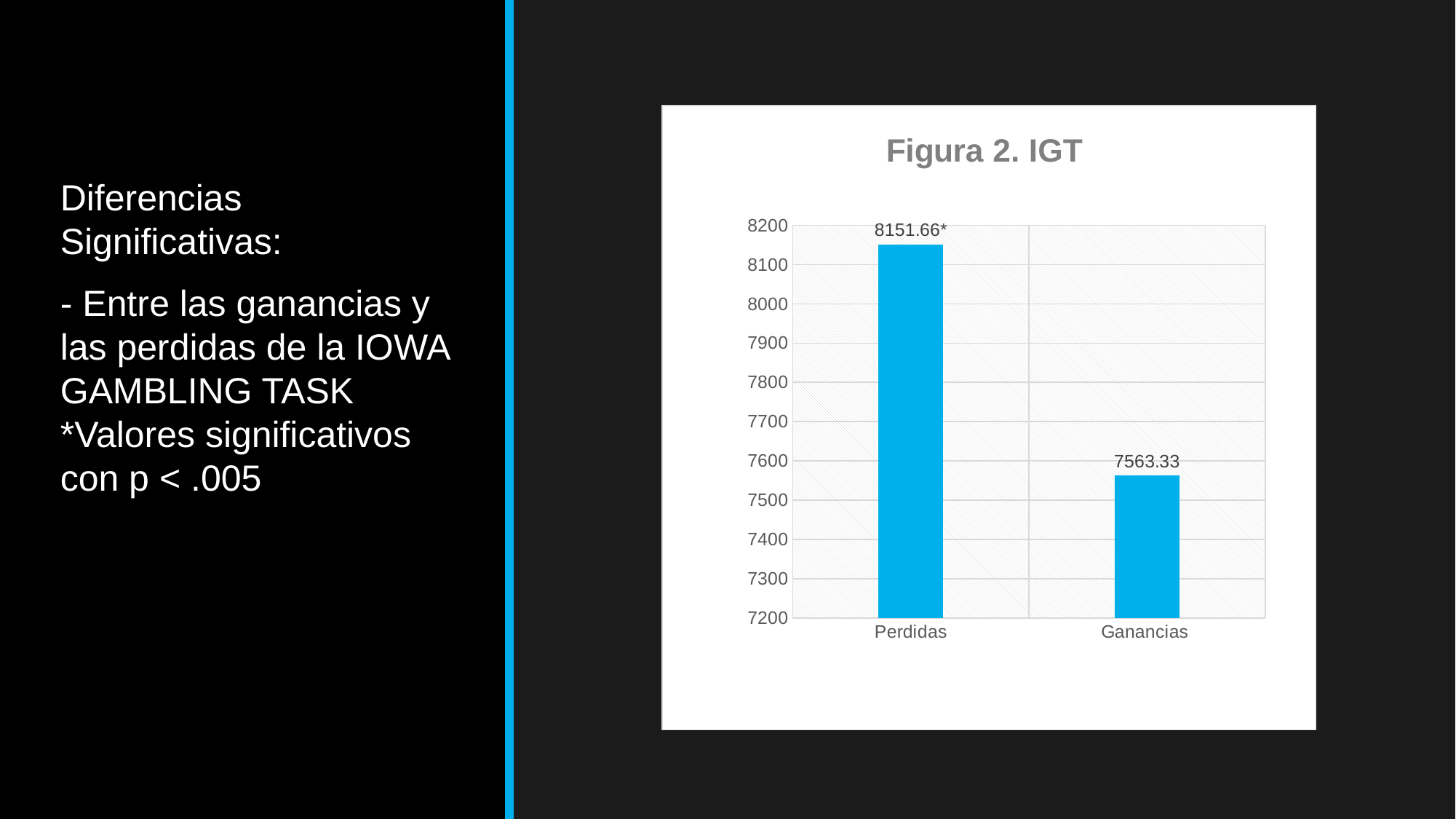
Which is larger, the value for Perdidas or the value for Ganancias? Perdidas How many categories are shown on the x axis? 2 Which category has the lowest value? Ganancias What is the difference between the values for Perdidas and Ganancias? 588.33 What is the value shown for Ganancias? 7563.33 Is the value for Ganancias greater or less than 7600? less What is the title of the chart? Figura 2. IGT Which category has the highest value? Perdidas What is the lowest value shown on the y axis? 7200 What kind of chart is shown on the slide? bar chart What is the value shown for Perdidas? 8151.66* Is the value for Perdidas greater or less than 8000? greater